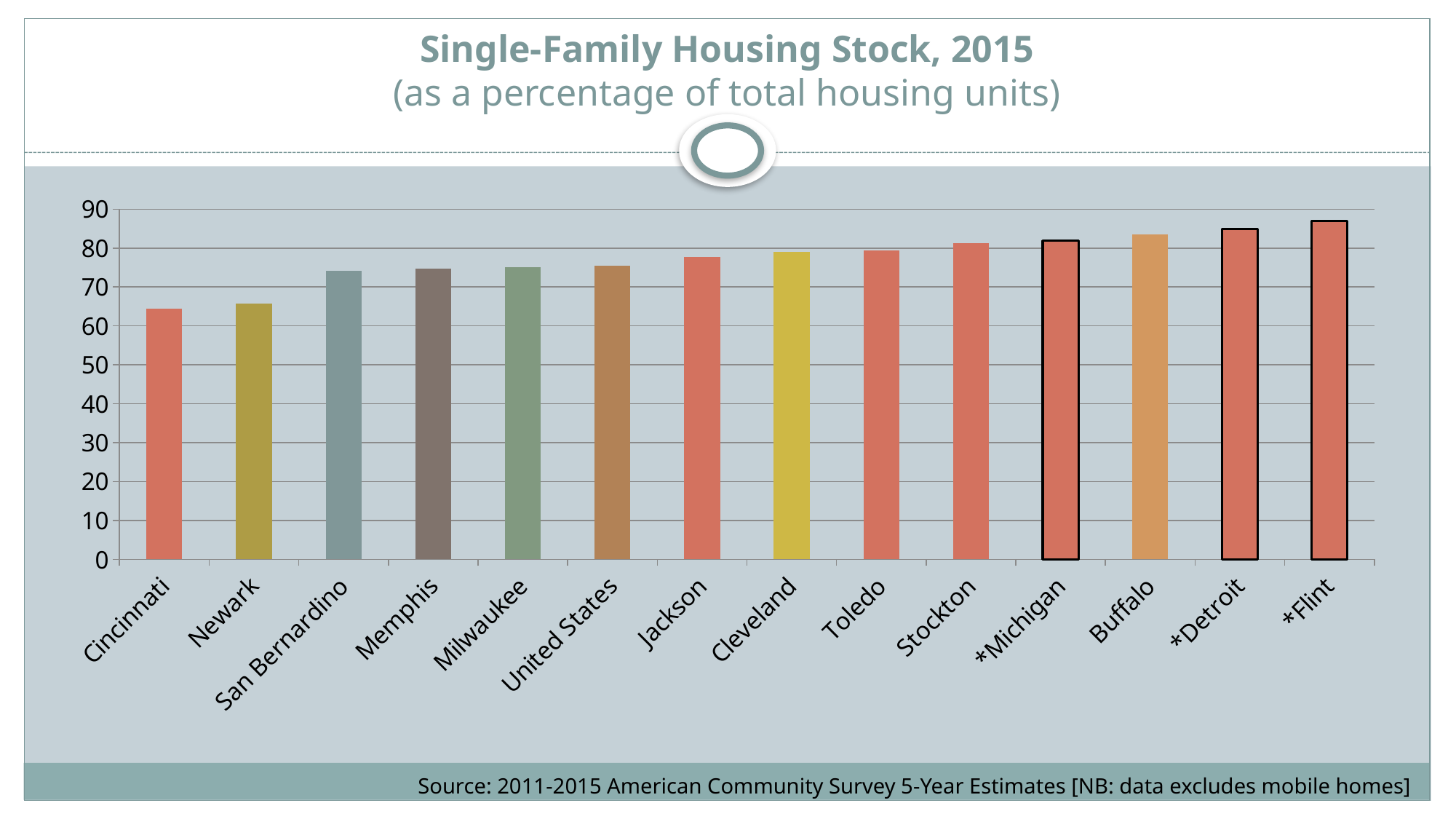
Do the values generally rise or fall moving from left to right along the x axis? rise Which is larger, the value for Cleveland or the value for Memphis? Cleveland What is the title of the chart? Single-Family Housing Stock, 2015 (as a percentage of total housing units) Is the value for Jackson greater or less than 80? less How many categories are plotted along the x axis? 14 Is the value for Newark greater or less than 60? greater Which category has the lowest single-family housing stock percentage? Cincinnati Which category has the highest single-family housing stock percentage? *Flint What kind of chart is shown on the slide? bar chart Is the value for Cincinnati greater or less than 70? less Which is larger, the value for *Detroit or the value for Newark? *Detroit